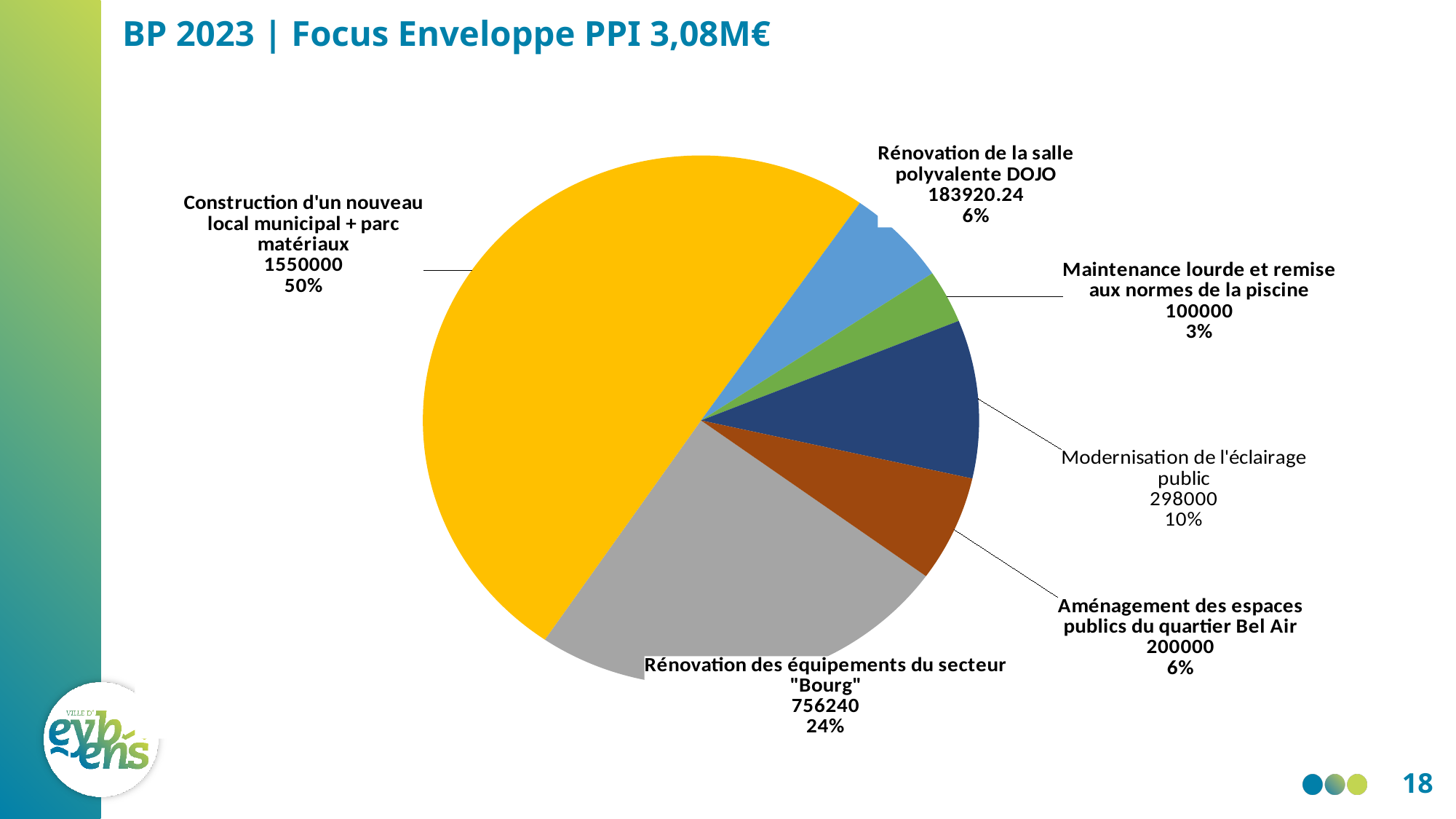
Which is larger: the value for "Rénovation des équipements du secteur "Bourg"" or the value for "Modernisation de l'éclairage public"? Rénovation des équipements du secteur "Bourg" What kind of chart is shown on the slide? pie chart What is the value for "Rénovation de la salle polyvalente DOJO"? 183920.24 How many slices does the pie chart have? 6 What share of the pie does "Maintenance lourde et remise aux normes de la piscine" represent? 3% What is the difference between the values for "Modernisation de l'éclairage public" and "Aménagement des espaces publics du quartier Bel Air"? 98000 What is the value for "Modernisation de l'éclairage public"? 298000 Which category has the smallest slice of the pie? Maintenance lourde et remise aux normes de la piscine What is the title of the slide containing the pie chart? BP 2023 | Focus Enveloppe PPI 3,08M€ Which category has the largest slice of the pie? Construction d'un nouveau local municipal + parc matériaux What share of the pie does "Rénovation des équipements du secteur "Bourg"" represent? 24% What is the value for "Construction d'un nouveau local municipal + parc matériaux"? 1550000